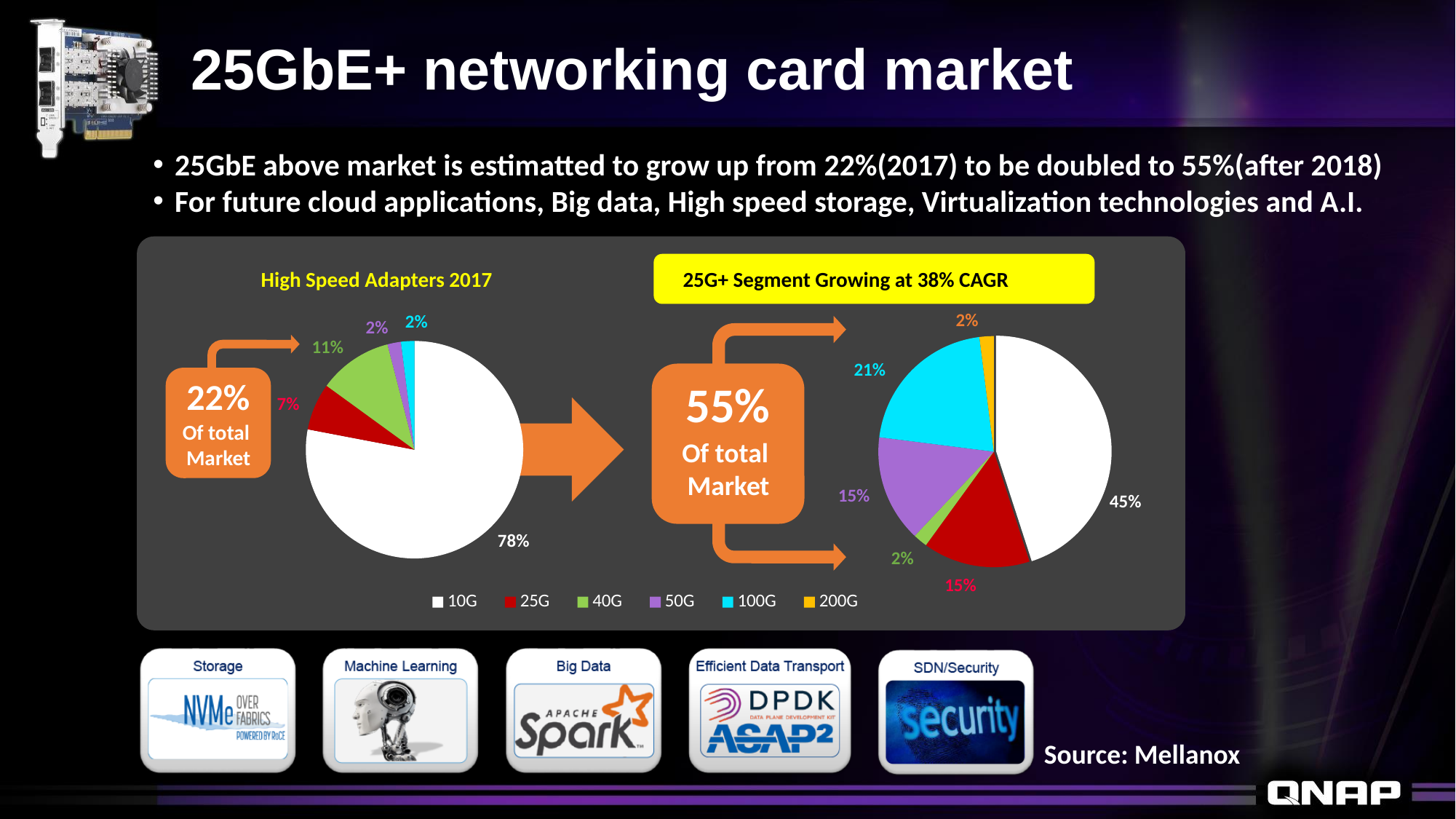
In the 'High Speed Adapters 2017' pie chart on the left, which is larger, the 40G slice or the 25G slice? 40G In the right-hand pie chart under '25G+ Segment Growing at 38% CAGR', what share does 100G hold? 21% In the right-hand pie chart under '25G+ Segment Growing at 38% CAGR', which category has the largest slice? 10G In the right-hand pie chart, what is the difference between the 10G share and the 100G share? 24% What type of chart is used to show the 'High Speed Adapters 2017' data? Pie chart How many series does the shared legend below the pie charts list? 6 In the right-hand pie chart under '25G+ Segment Growing at 38% CAGR', what share does 10G hold? 45% In the 'High Speed Adapters 2017' pie chart on the left, which category has the largest slice? 10G In the 'High Speed Adapters 2017' pie chart on the left, what share does 25G hold? 7% In the 'High Speed Adapters 2017' pie chart on the left, what share does 10G hold? 78% In the legend below the pie charts, which colour represents 100G? Cyan (light blue) In the 'High Speed Adapters 2017' pie chart on the left, what share does 40G hold? 11%